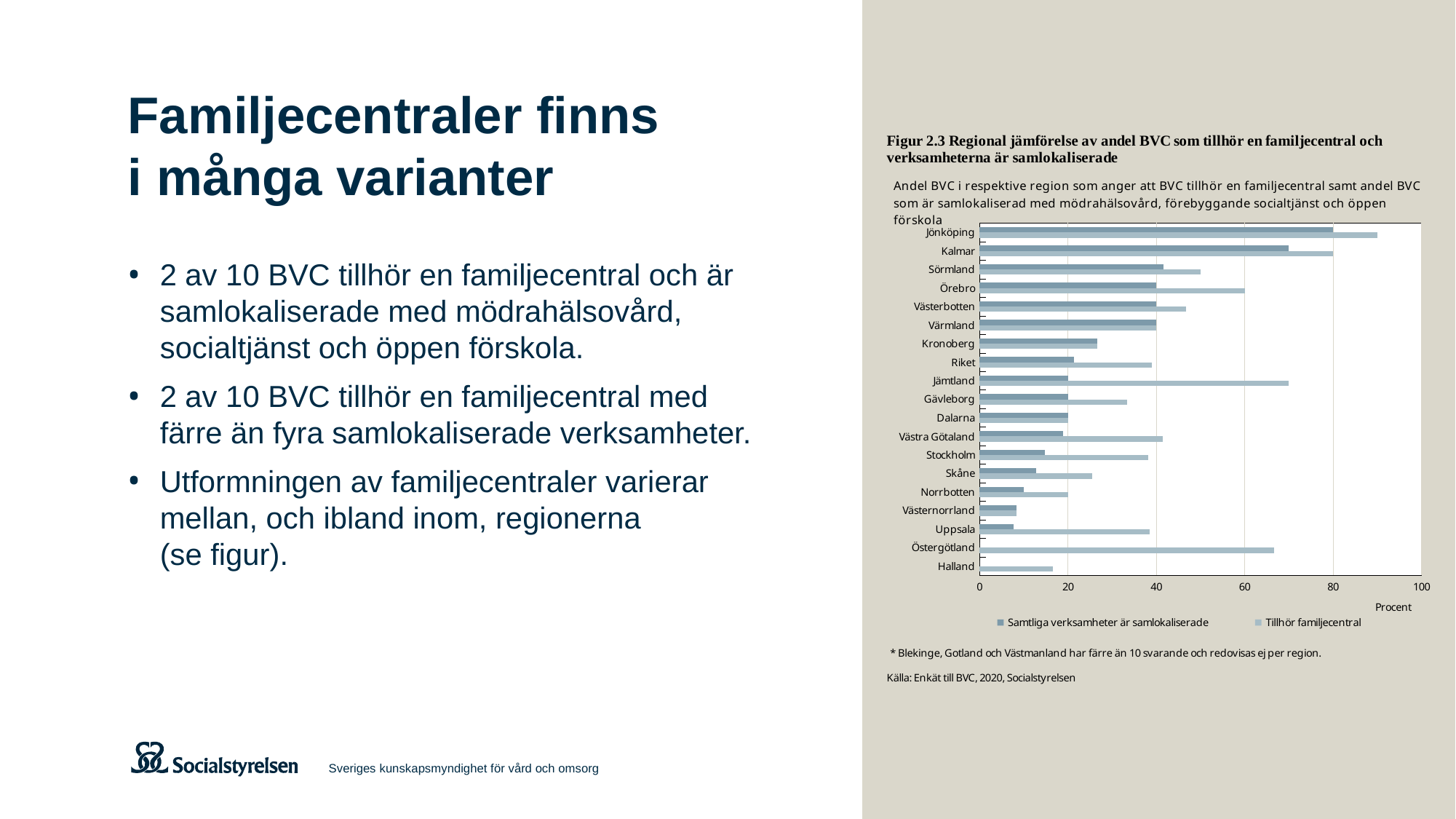
Is the 'Tillhör familjecentral' value for Östergötland greater or less than 60? greater How many series does the legend of the chart list? 2 Which region has the larger 'Samtliga verksamheter är samlokaliserade' value, Kalmar or Sörmland? Kalmar For Jämtland, which series has the larger value: 'Samtliga verksamheter är samlokaliserade' or 'Tillhör familjecentral'? Tillhör familjecentral Is the 'Tillhör familjecentral' value for Halland greater or less than 20? less What kind of chart is shown in Figur 2.3? Bar chart Is the 'Tillhör familjecentral' value for Jönköping greater or less than 80? greater How many regions (categories) are plotted on the chart? 19 Which region has the highest value for 'Samtliga verksamheter är samlokaliserade'? Jönköping Which region has the lowest value for 'Tillhör familjecentral'? Västernorrland Which region has the highest value for 'Tillhör familjecentral'? Jönköping